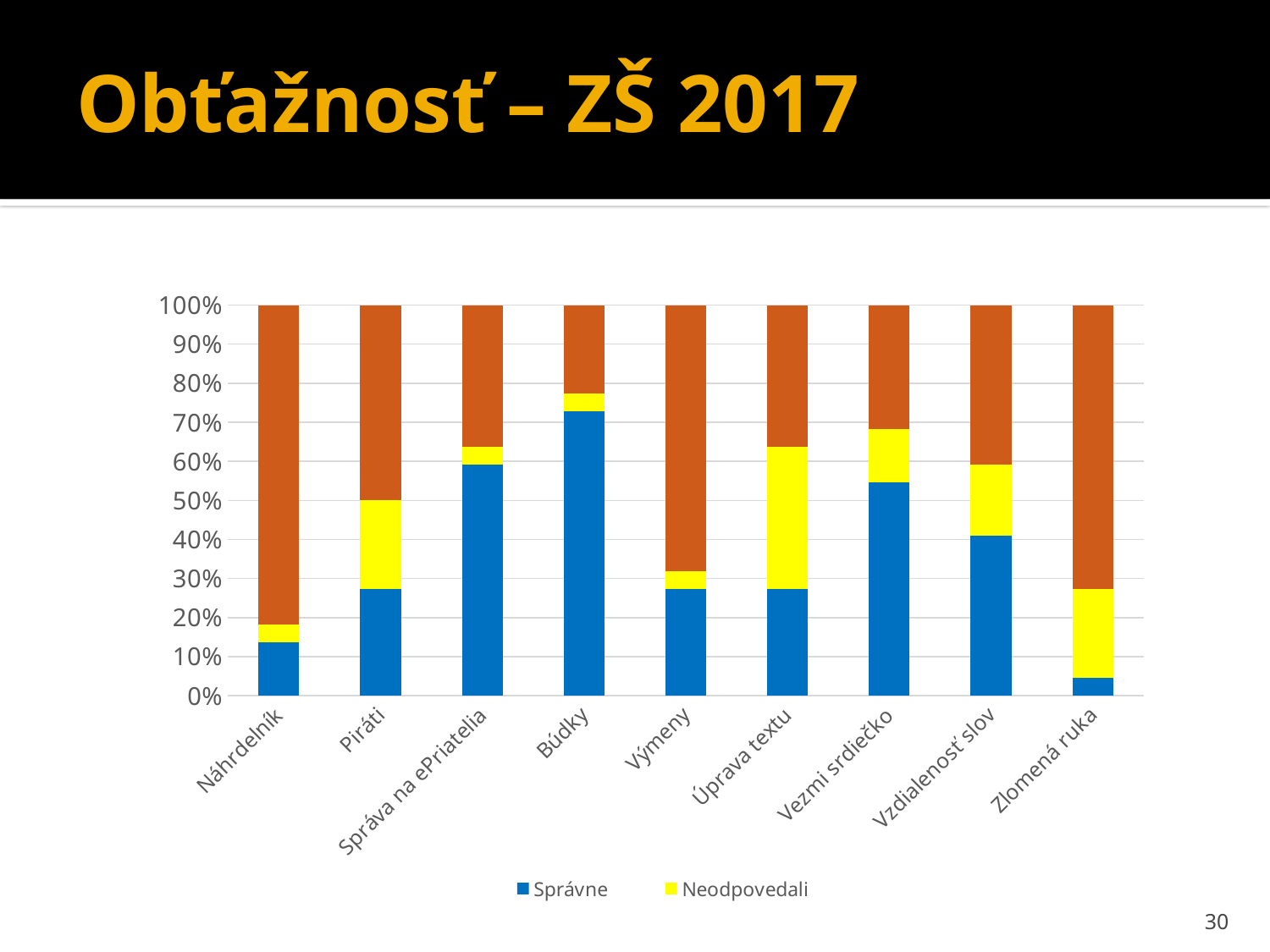
Which category has the largest Neodpovedali segment? Úprava textu Is the Správne value for Búdky greater or less than 70%? greater Is the Správne value for Vezmi srdiečko greater or less than 50%? greater Is the Správne value for Náhrdelník greater or less than 20%? less How many categories are shown on the x axis of the chart? 9 Which has the larger Správne value, Piráti or Zlomená ruka? Piráti What is the title of the slide containing the chart? Obťažnosť – ZŠ 2017 How many series does the chart's legend list? 2 Which category has the lowest Správne value? Zlomená ruka What kind of chart is shown on the slide? Stacked bar chart Which category has the highest Správne value? Búdky Which has the larger Správne value, Búdky or Správa na ePriatelia? Búdky